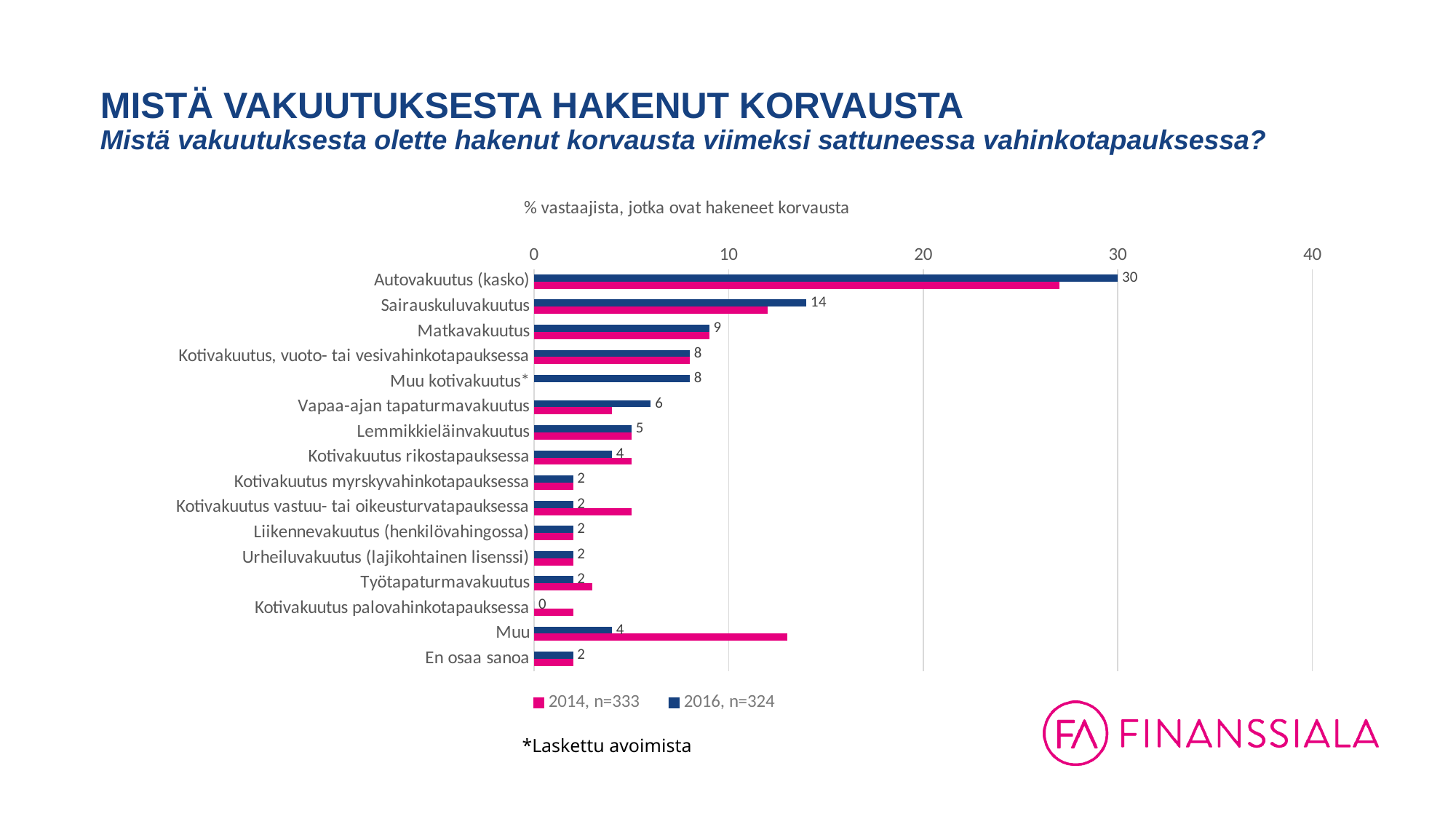
What is the 2016 value for Autovakuutus (kasko)? 30 Is the 2014 value for Autovakuutus (kasko) greater or less than 20? greater How many series does the legend list? 2 Which category has the highest 2016 value? Autovakuutus (kasko) What kind of chart is shown on the slide? Bar chart What is the difference between the 2016 values for Autovakuutus (kasko) and Sairauskuluvakuutus? 16 Is the 2014 value for Muu greater or less than 10? greater What is the 2016 value for Lemmikkieläinvakuutus? 5 What is the 2016 value for Sairauskuluvakuutus? 14 Which category has the lowest 2016 value? Kotivakuutus palovahinkotapauksessa Which has the larger 2016 value, Matkavakuutus or Vapaa-ajan tapaturmavakuutus? Matkavakuutus How many categories are shown on the chart? 16